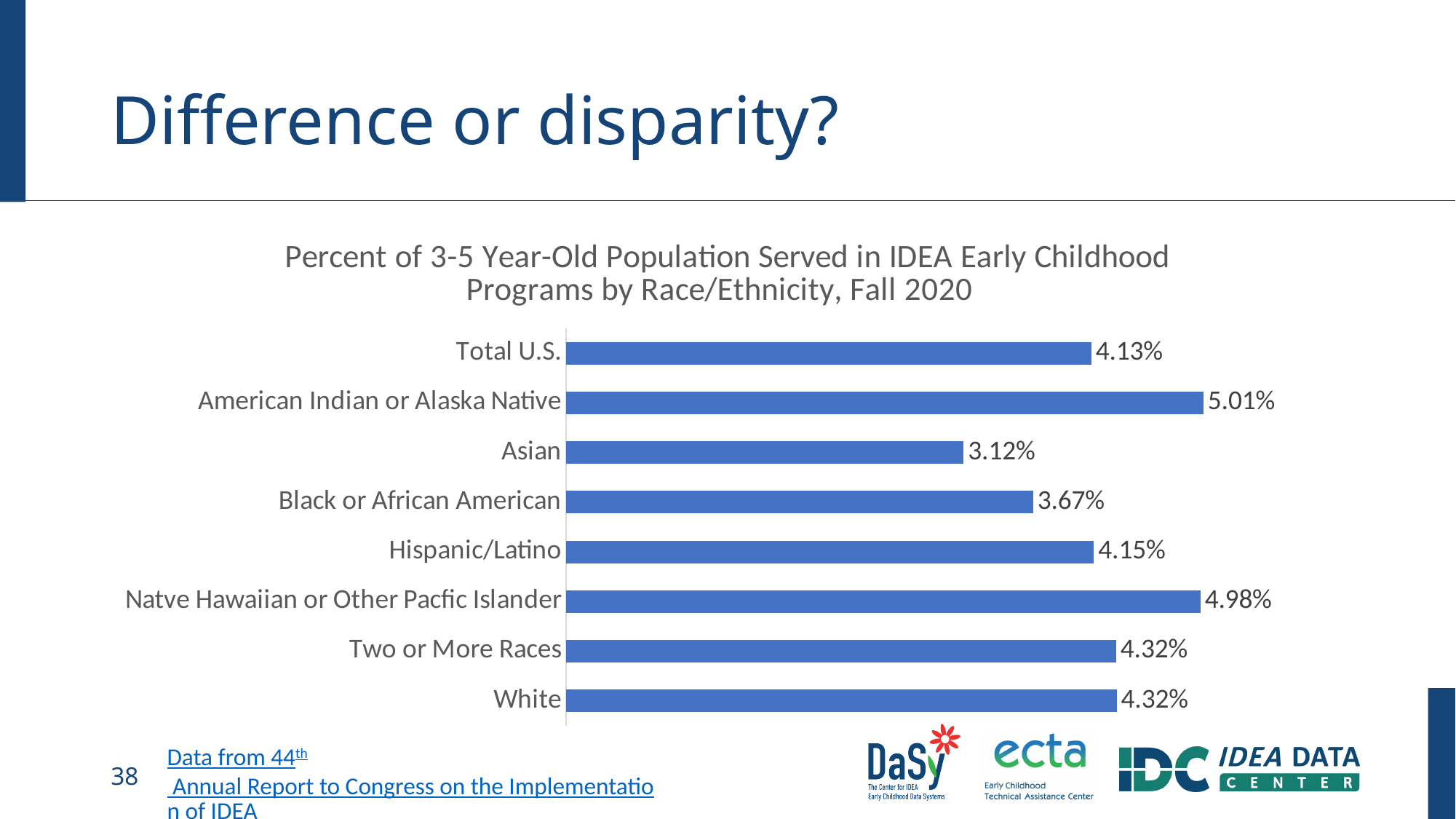
What is the title of the chart? Percent of 3-5 Year-Old Population Served in IDEA Early Childhood Programs by Race/Ethnicity, Fall 2020 How many categories are shown in the chart? 8 What kind of chart is shown on the slide? Bar chart What is the value for Black or African American? 3.67% Which category has the highest value? American Indian or Alaska Native Which category has the lowest value? Asian What is the difference between the values for American Indian or Alaska Native and Asian? 1.89% What is the value for American Indian or Alaska Native? 5.01% What is the value for Asian? 3.12% What is the value for Total U.S.? 4.13% What is the difference between the values for White and Black or African American? 0.65% Which is larger, the value for Hispanic/Latino or the value for Black or African American? Hispanic/Latino